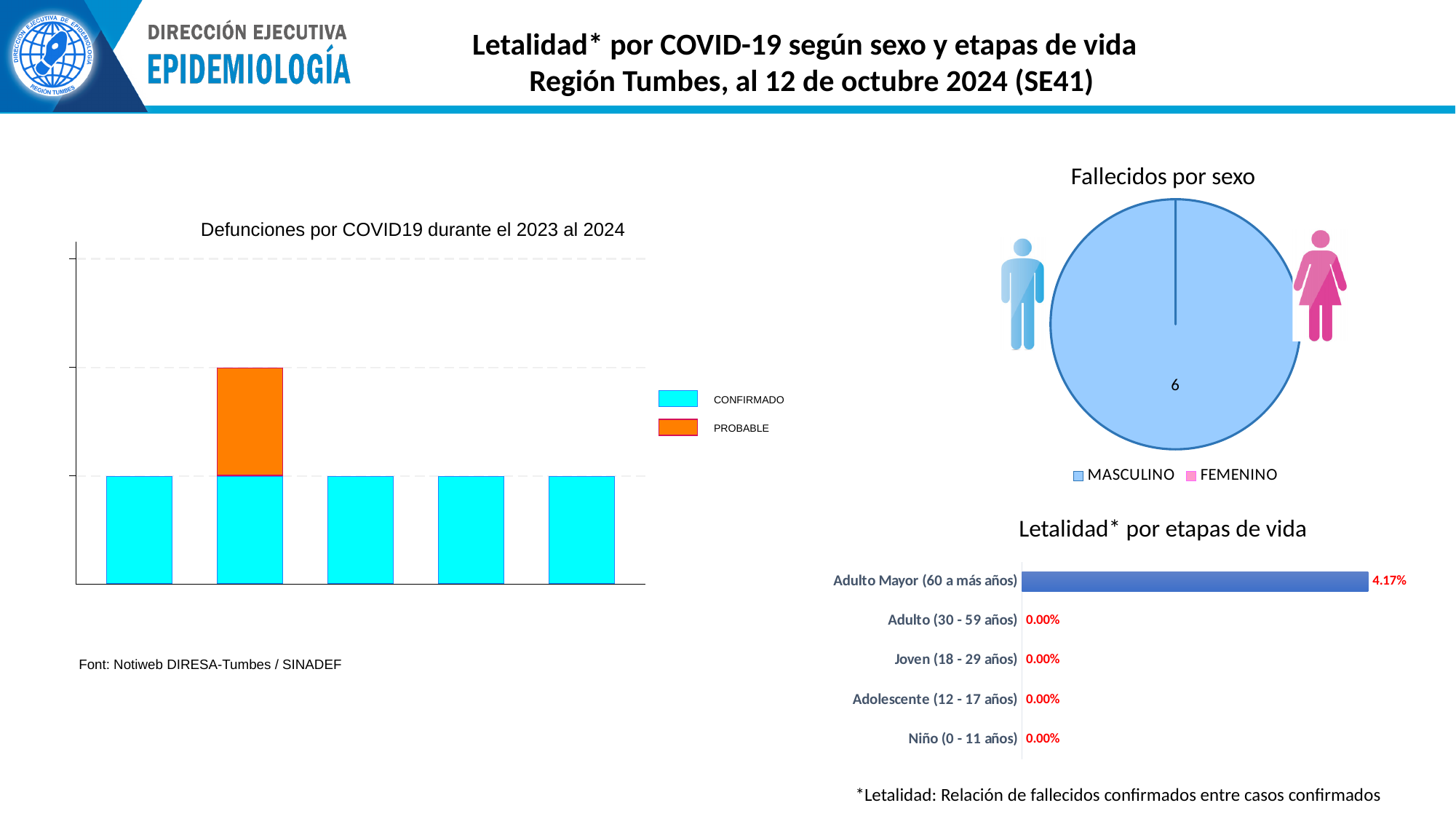
In the 'Letalidad* por etapas de vida' chart, how many age groups are shown? 5 What kind of chart is 'Fallecidos por sexo'? Pie chart What kind of chart is 'Letalidad* por etapas de vida'? Bar chart In the 'Letalidad* por etapas de vida' chart, what is the value for Adulto Mayor (60 a más años)? 4.17% How many bars are shown in the 'Defunciones por COVID19 durante el 2023 al 2024' chart? 5 In the 'Defunciones por COVID19 durante el 2023 al 2024' chart, which colour represents PROBABLE? Orange In the 'Letalidad* por etapas de vida' chart, what is the difference between the values for Adulto Mayor (60 a más años) and Niño (0 - 11 años)? 4.17% In the 'Fallecidos por sexo' chart, what value is shown for MASCULINO? 6 In the 'Letalidad* por etapas de vida' chart, which age group has the highest value? Adulto Mayor (60 a más años) How many entries does the legend of the 'Fallecidos por sexo' chart list? 2 How many series does the legend of the 'Defunciones por COVID19 durante el 2023 al 2024' chart list? 2 In the 'Letalidad* por etapas de vida' chart, what is the value for Adulto (30 - 59 años)? 0.00%